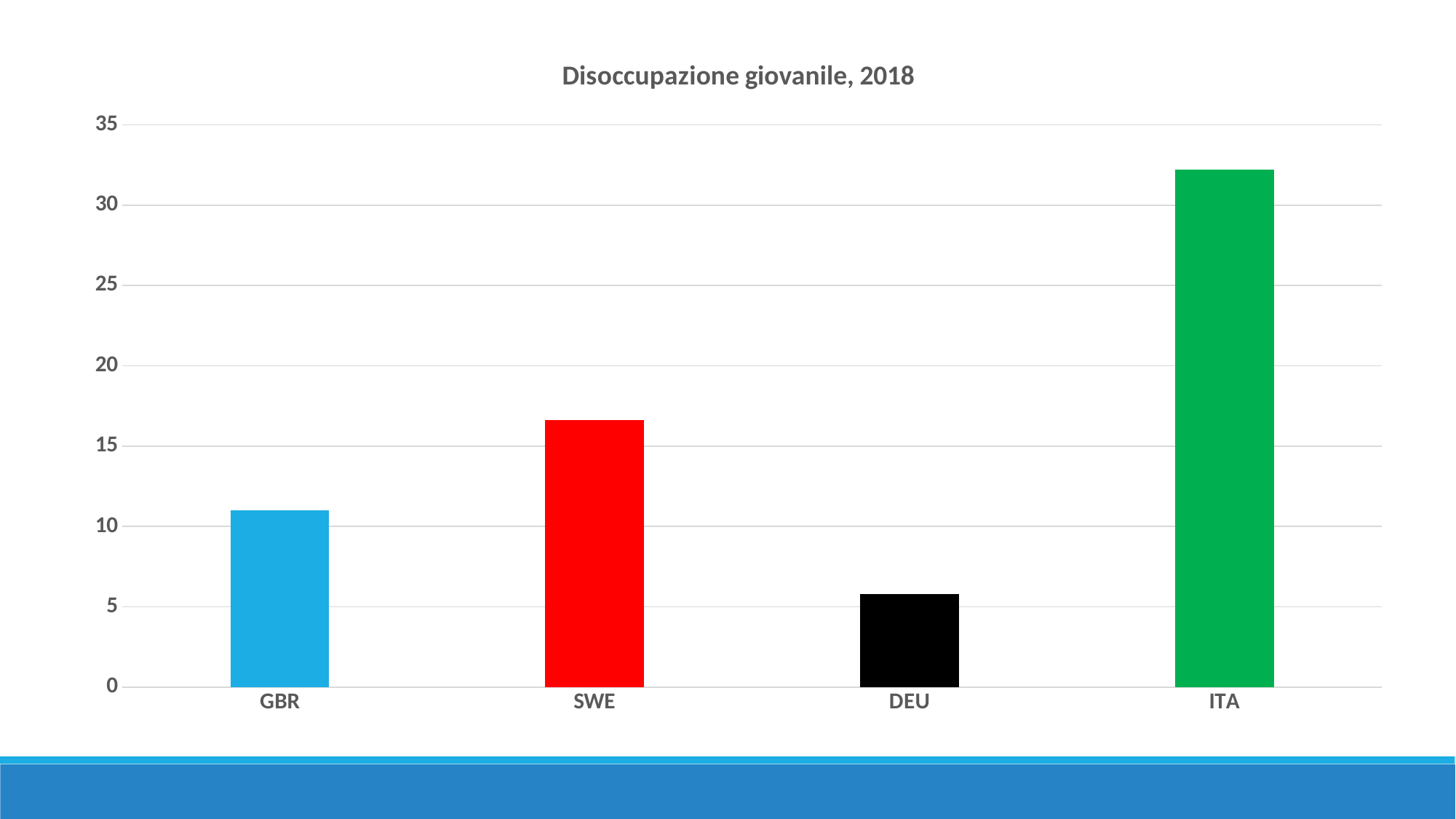
How many countries are shown in the chart? 4 Is the value for ITA greater or less than 30? greater Which is larger, the value for SWE or the value for GBR? SWE Which country has the lowest youth unemployment value in the chart? DEU What colour is the bar for ITA? green Is the value for DEU greater or less than 10? less Which country has the highest youth unemployment value in the chart? ITA What is the title of the chart? Disoccupazione giovanile, 2018 Is the value for GBR greater or less than 15? less What type of chart is shown on the slide? bar chart Which is larger, the value for DEU or the value for ITA? ITA